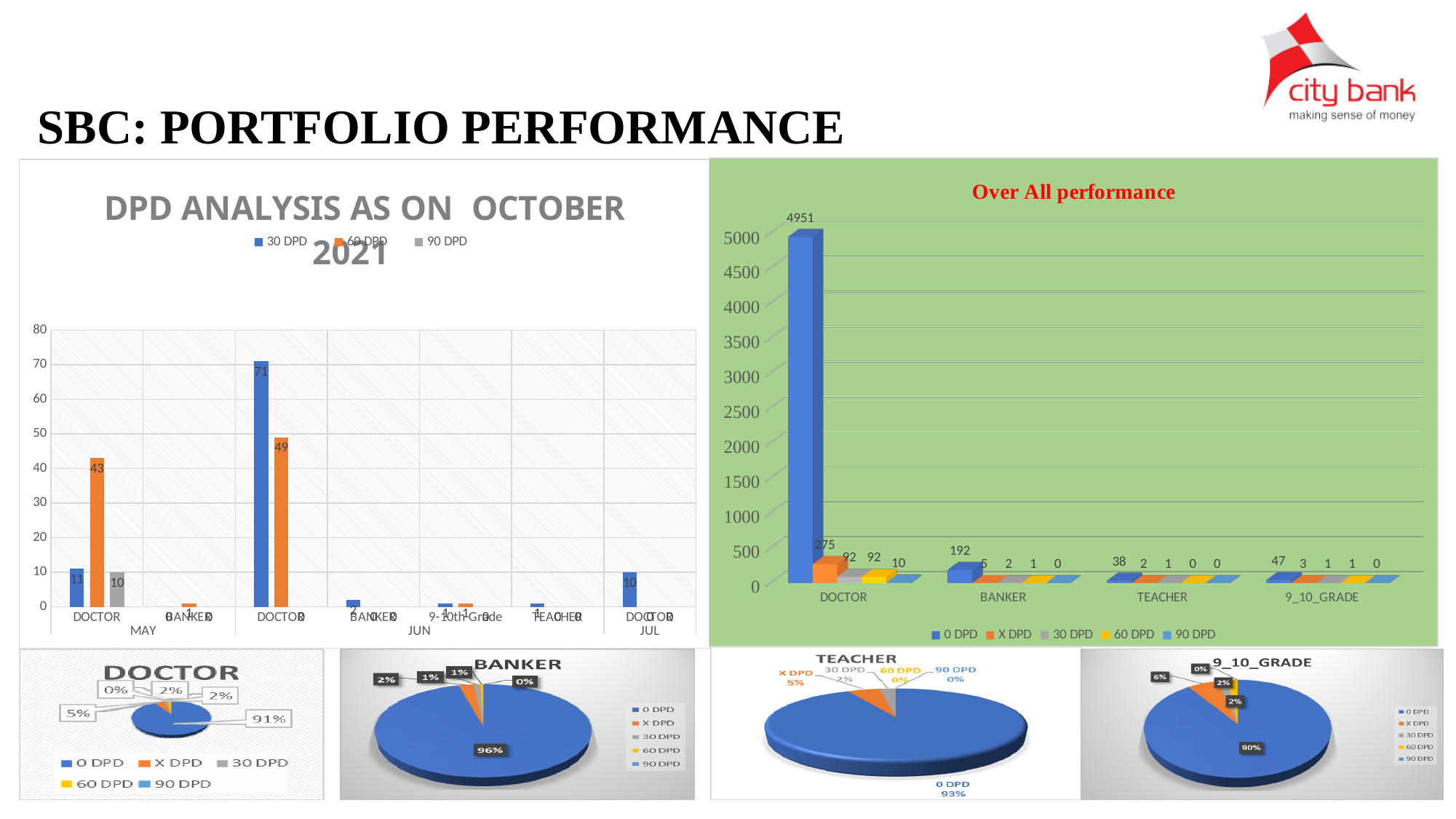
How many series does the legend of the 'Over All performance' chart list? 5 In the 'Over All performance' chart, what is the 0 DPD value for BANKER? 192 In the BANKER pie chart, what share does 0 DPD have? 96% In the 'DPD ANALYSIS AS ON OCTOBER 2021' chart, what is the 30 DPD value for DOCTOR in JUN? 71 In the 'Over All performance' chart, what is the 0 DPD value for DOCTOR? 4951 What kind of chart is 'DPD ANALYSIS AS ON OCTOBER 2021'? Bar chart In the 'Over All performance' chart, which category has the highest 0 DPD value? DOCTOR In the 'DPD ANALYSIS AS ON OCTOBER 2021' chart, what is the 60 DPD value for DOCTOR in MAY? 43 In the 'Over All performance' chart, what is the X DPD value for DOCTOR? 275 In the 'Over All performance' chart, what is the difference between the 0 DPD values for 9_10_GRADE and TEACHER? 9 In the 'DPD ANALYSIS AS ON OCTOBER 2021' chart, which is larger for DOCTOR in JUN: the 30 DPD value or the 60 DPD value? 30 DPD In the TEACHER pie chart, what share does 0 DPD have? 93%